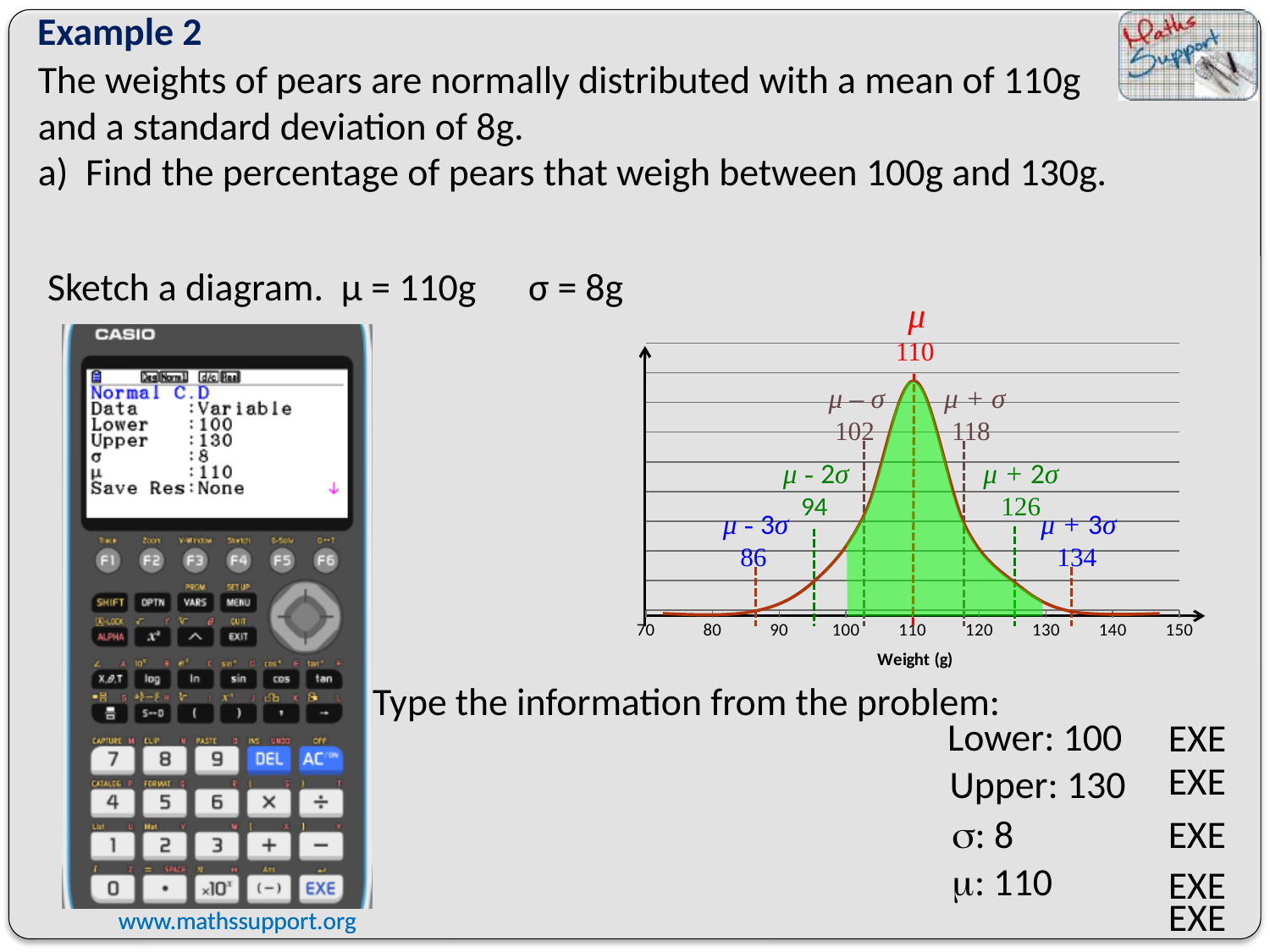
On the normal distribution chart, what weight is labelled at μ − 3σ? 86 On the normal distribution chart, what weight is labelled at μ + 2σ? 126 What is the highest value shown on the x-axis of the normal distribution chart? 150 On the normal distribution chart, what is the difference between the weights labelled at μ + 3σ and μ − 3σ? 48 What is the lowest value shown on the x-axis of the normal distribution chart? 70 On the normal distribution chart, what weight is labelled at μ + σ? 118 Between which two weights on the x-axis is the green shaded region of the normal distribution chart? 100 and 130 On the normal distribution chart, what weight is labelled at μ + 3σ? 134 On the normal distribution chart, what weight is labelled at μ − 2σ? 94 On the normal distribution chart, what weight is labelled at μ − σ? 102 What is the x-axis title of the normal distribution chart? Weight (g) On the normal distribution chart, what weight is labelled at μ? 110